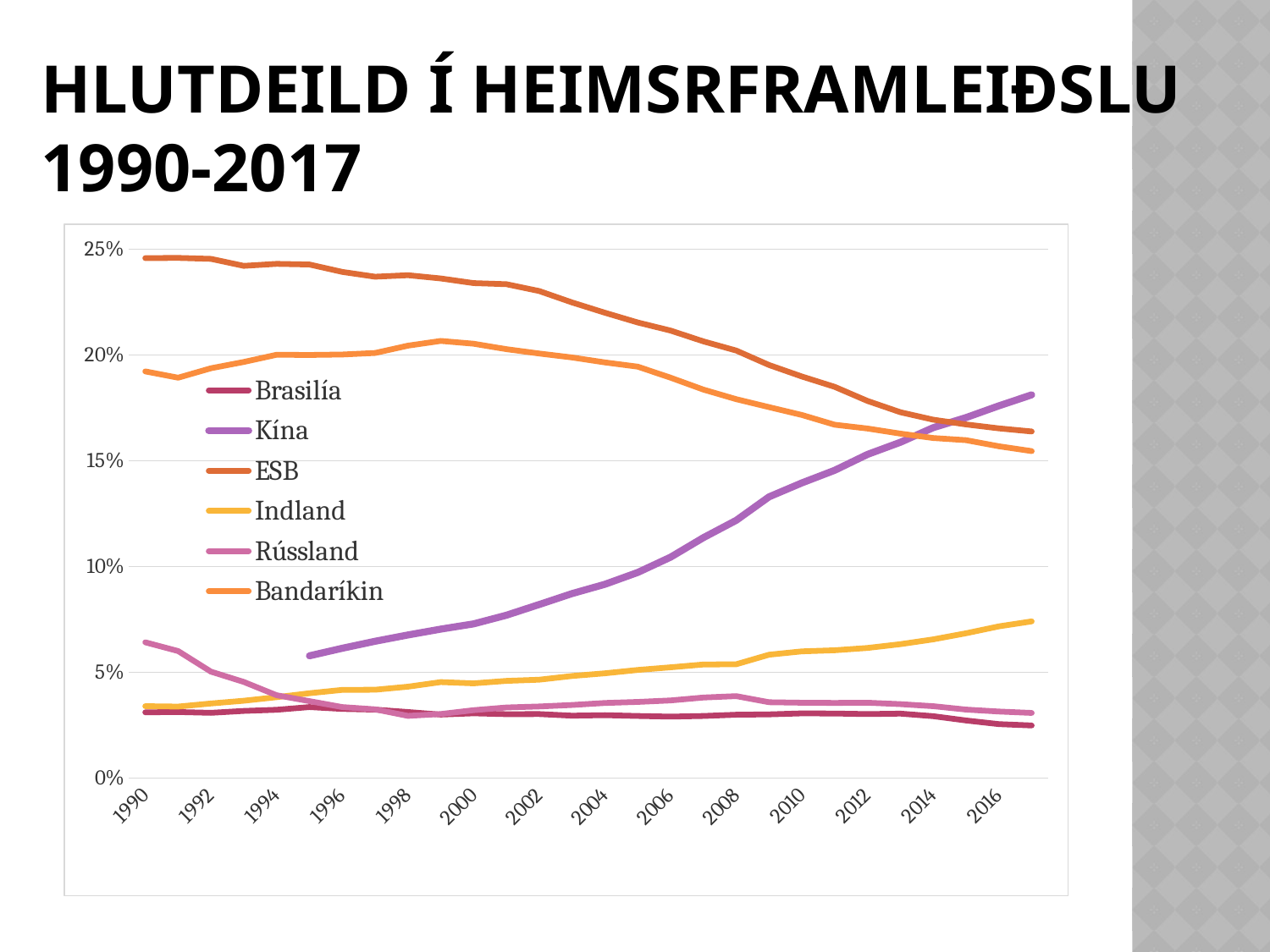
How many series does the legend list? 6 Which series has the lowest value at the end of the period (2016-2017)? Brasilía Is the value for ESB in 1990 greater or less than 20%? greater Does the value for ESB rise or fall over the period shown? fall Which series has the highest value in 1990? ESB Which is larger in 2000, the value for Bandaríkin or the value for Kína? Bandaríkin Is the value for Indland in 2016 greater or less than 10%? less What is the title of the chart on the slide? HLUTDEILD Í HEIMSRFRAMLEIÐSLU 1990-2017 Is the value for Kína in 2016 greater or less than 15%? greater Which is larger in 2016, the value for Kína or the value for Bandaríkin? Kína What kind of chart is shown on the slide? line chart Does the value for Kína rise or fall over the period shown? rise